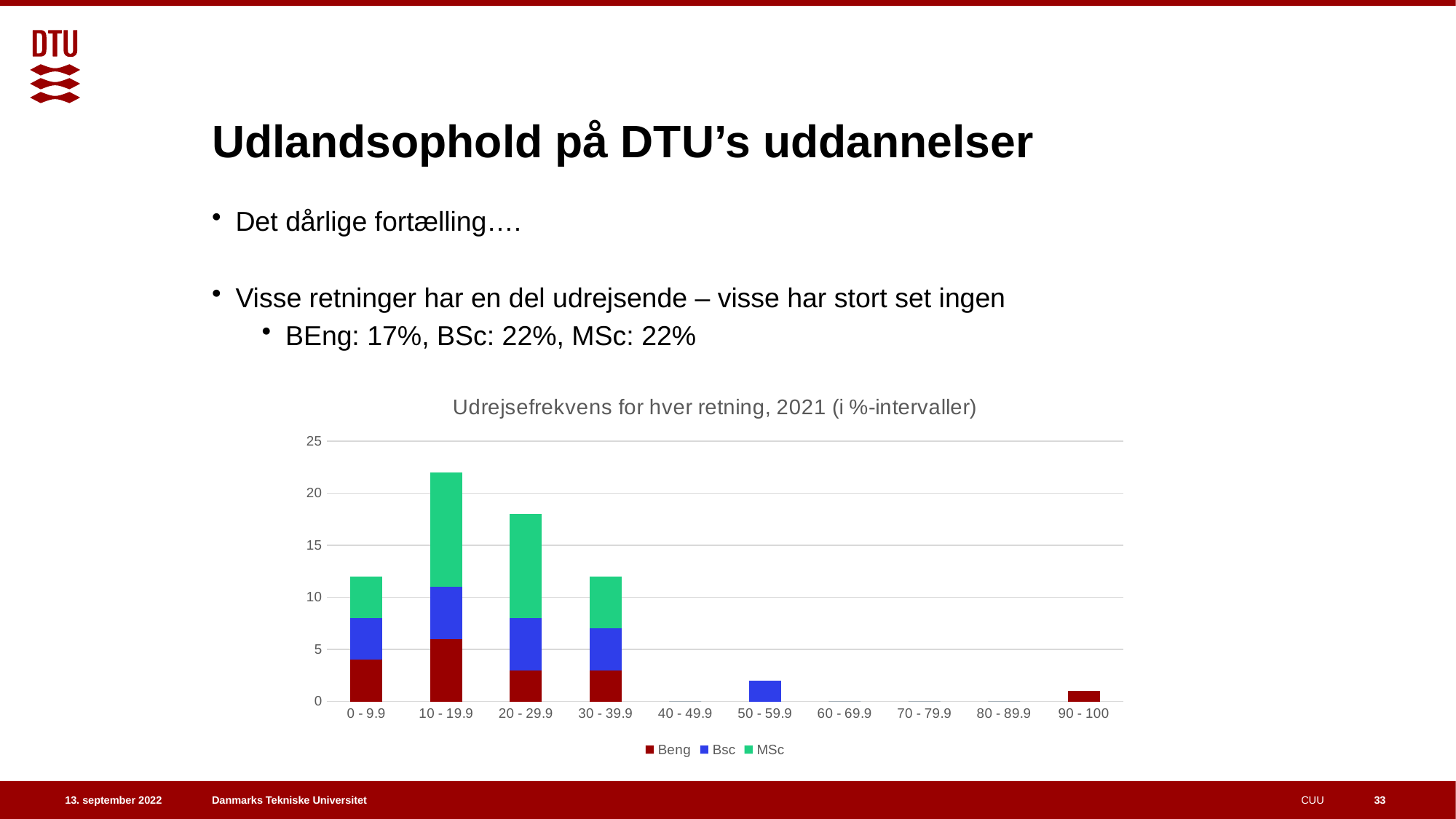
Which series is the only one with a visible bar in the 90 - 100 category? Beng Which stacked bar is taller, 10 - 19.9 or 20 - 29.9? 10 - 19.9 How many categories are shown on the x axis of the chart? 10 Is the total of the stacked bar for 0 - 9.9 greater or less than 15? less How many series does the chart's legend list? 3 Which stacked bar is taller, 20 - 29.9 or 30 - 39.9? 20 - 29.9 What is the title of the chart? Udrejsefrekvens for hver retning, 2021 (i %-intervaller) Is the value for 50 - 59.9 greater or less than 5? less Is the total of the stacked bar for 20 - 29.9 greater or less than 15? greater What kind of chart is shown on the slide? Stacked bar chart Which category has the tallest stacked bar? 10 - 19.9